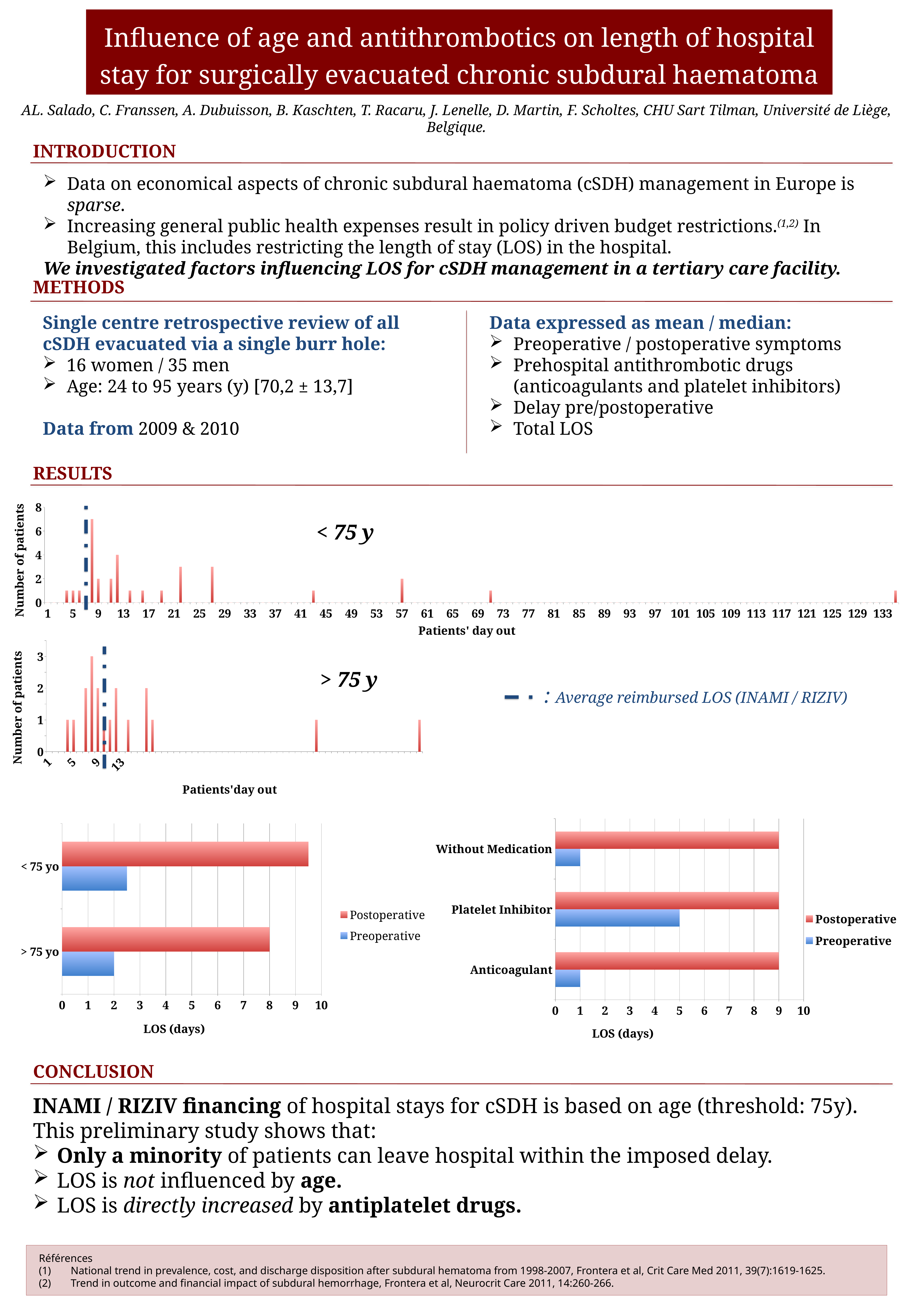
In the bottom-left chart, is the Postoperative LOS for < 75 yo greater or less than 9? greater In the bottom-right chart, what is the difference between the Preoperative LOS for Platelet Inhibitor and for Anticoagulant? 4 In the bottom-left chart, what is the Preoperative LOS (days) for > 75 yo? 2 In the bottom-right chart (Without Medication / Platelet Inhibitor / Anticoagulant), how many series does the legend list? 2 In the bottom-left chart, what is the Postoperative LOS (days) for > 75 yo? 8 What kind of chart is the bottom-left chart comparing < 75 yo and > 75 yo LOS? bar chart In the bottom-right chart, which category has the highest Preoperative LOS? Platelet Inhibitor In the bottom-right chart, what is the Preoperative LOS (days) for Platelet Inhibitor? 5 How many medication categories are shown in the bottom-right chart? 3 In the bottom-left chart, which age group has the larger Postoperative LOS, < 75 yo or > 75 yo? < 75 yo In the > 75 y chart, what is the highest number of patients reached by any bar? 3 In the bottom-right chart, what is the Postoperative LOS (days) for Anticoagulant? 9